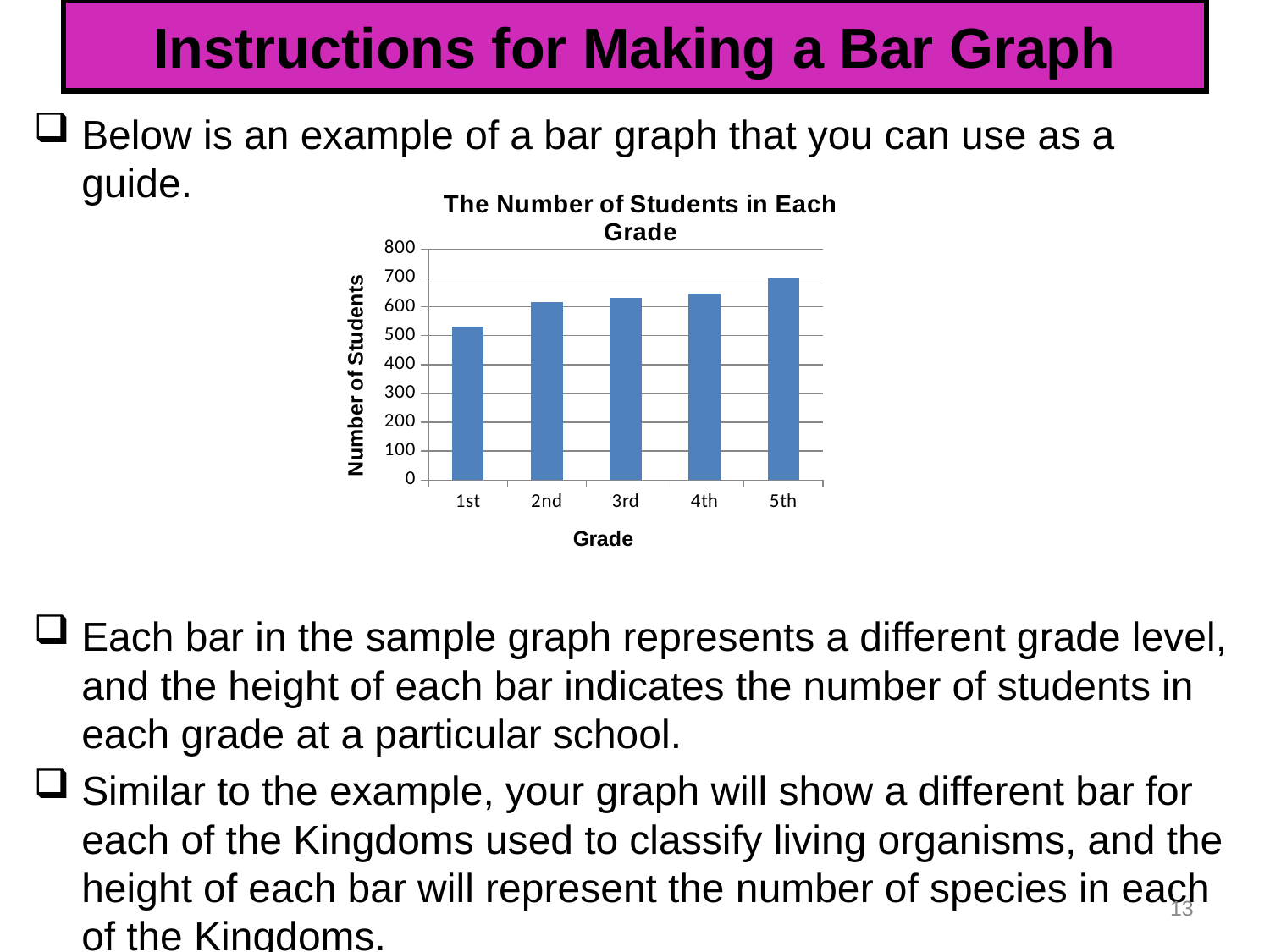
Which grade has more students, 1st or 5th? 5th Which grade has the highest number of students? 5th Is the number of students in 4th grade greater or less than 700? less How many grades are shown as bars in the chart? 5 What kind of chart is shown on the slide? bar chart Which grade has the lowest number of students? 1st What is the number of students in 5th grade? 700 Is the number of students in 1st grade greater or less than 500? greater Do the number of students rise or fall from 1st grade to 5th grade? rise What is the label on the vertical axis of the chart? Number of Students What is the title of the chart? The Number of Students in Each Grade Is the number of students in 1st grade greater or less than 600? less